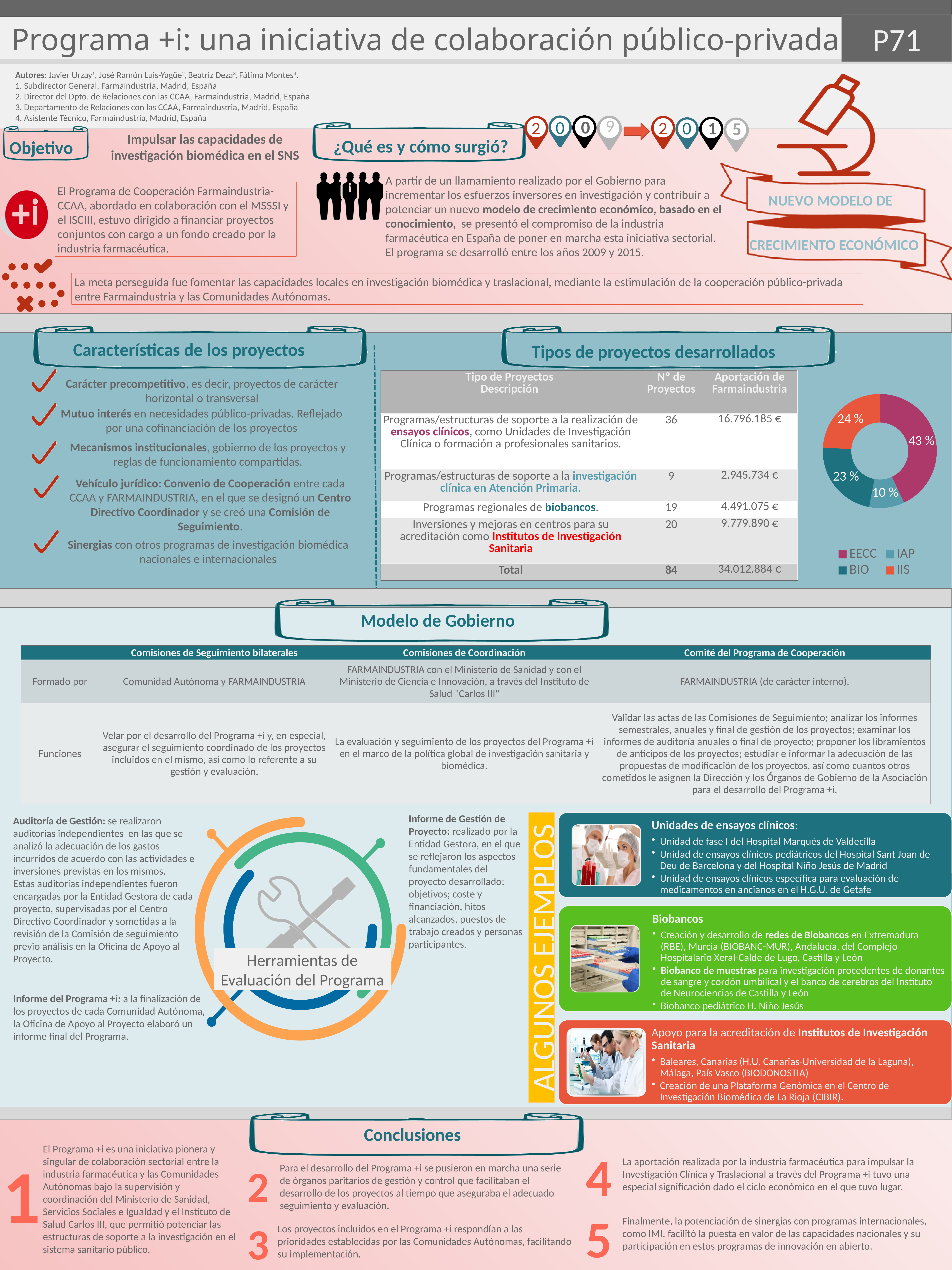
How many slices does the pie chart have? 4 In the pie chart, what share is shown for BIO? 23 % In the pie chart, what share is shown for IAP? 10 % How many categories does the pie chart legend list? 4 What is the difference in percentage points between the EECC slice and the IAP slice in the pie chart? 33 Which category has the smallest slice in the pie chart? IAP In the pie chart, what share is shown for IIS? 24 % In the pie chart, what share is shown for EECC? 43 % What colour is the EECC slice in the pie chart? Magenta/pink In the pie chart, which slice is larger, BIO or IIS? IIS What type of chart is shown next to the 'Tipos de proyectos desarrollados' table? Pie chart (donut) Which category has the largest slice in the pie chart? EECC